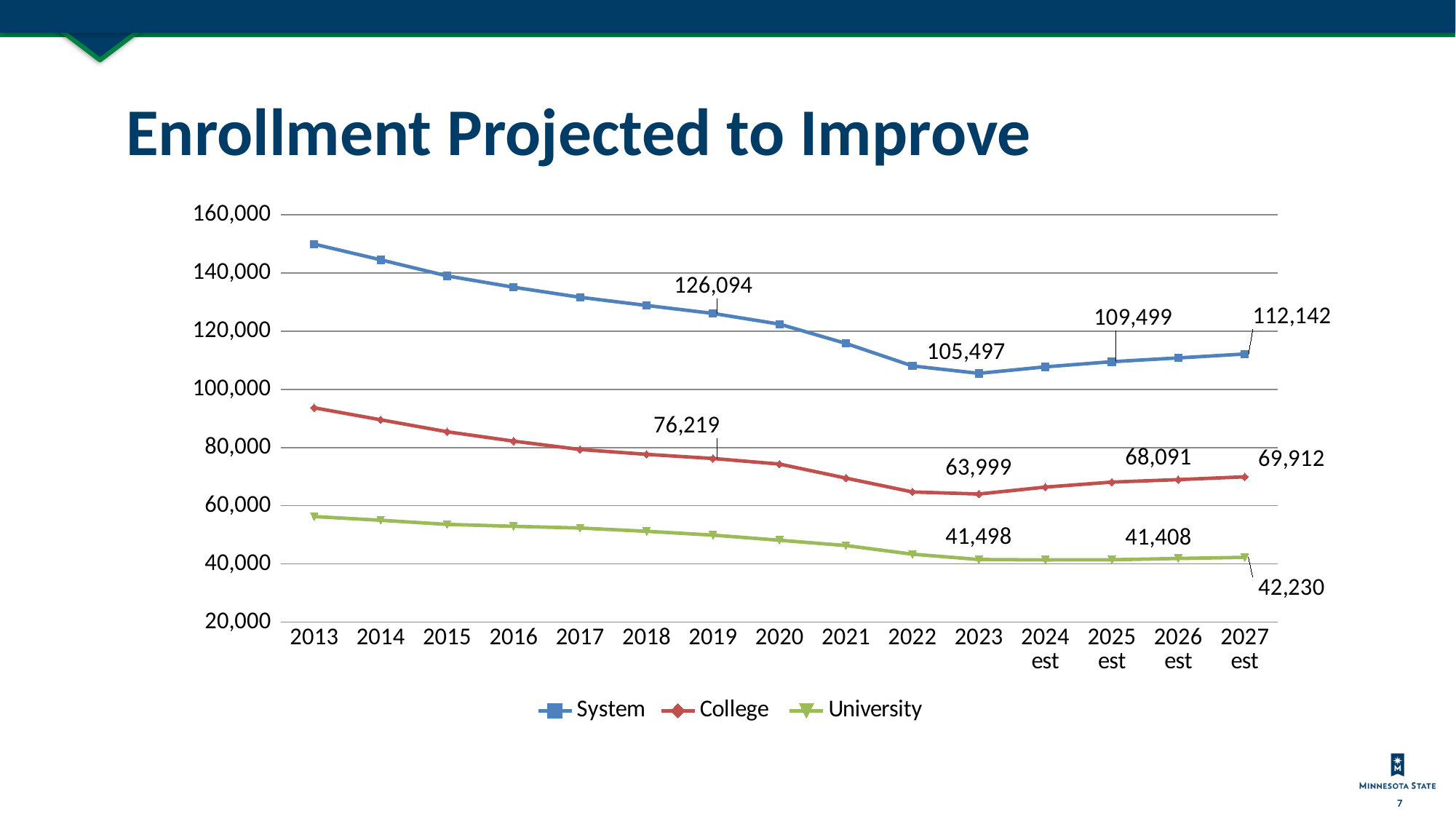
What is the College enrollment value labeled for 2023? 63,999 Is the System value for 2013 greater or less than 140,000? greater What is the difference between the System values labeled for 2027 est and 2023? 6,645 What is the System enrollment value labeled for 2019? 126,094 Does the System enrollment rise or fall from 2013 to 2023? fall What is the System enrollment value labeled for 2025 est? 109,499 What kind of chart is shown on the slide? line chart Which series has the highest enrollment across all years: System, College, or University? System What is the difference between the College values labeled for 2019 and 2023? 12,220 Is the University value for 2013 greater or less than 60,000? less What is the University enrollment value labeled for 2027 est? 42,230 How many series does the legend list? 3